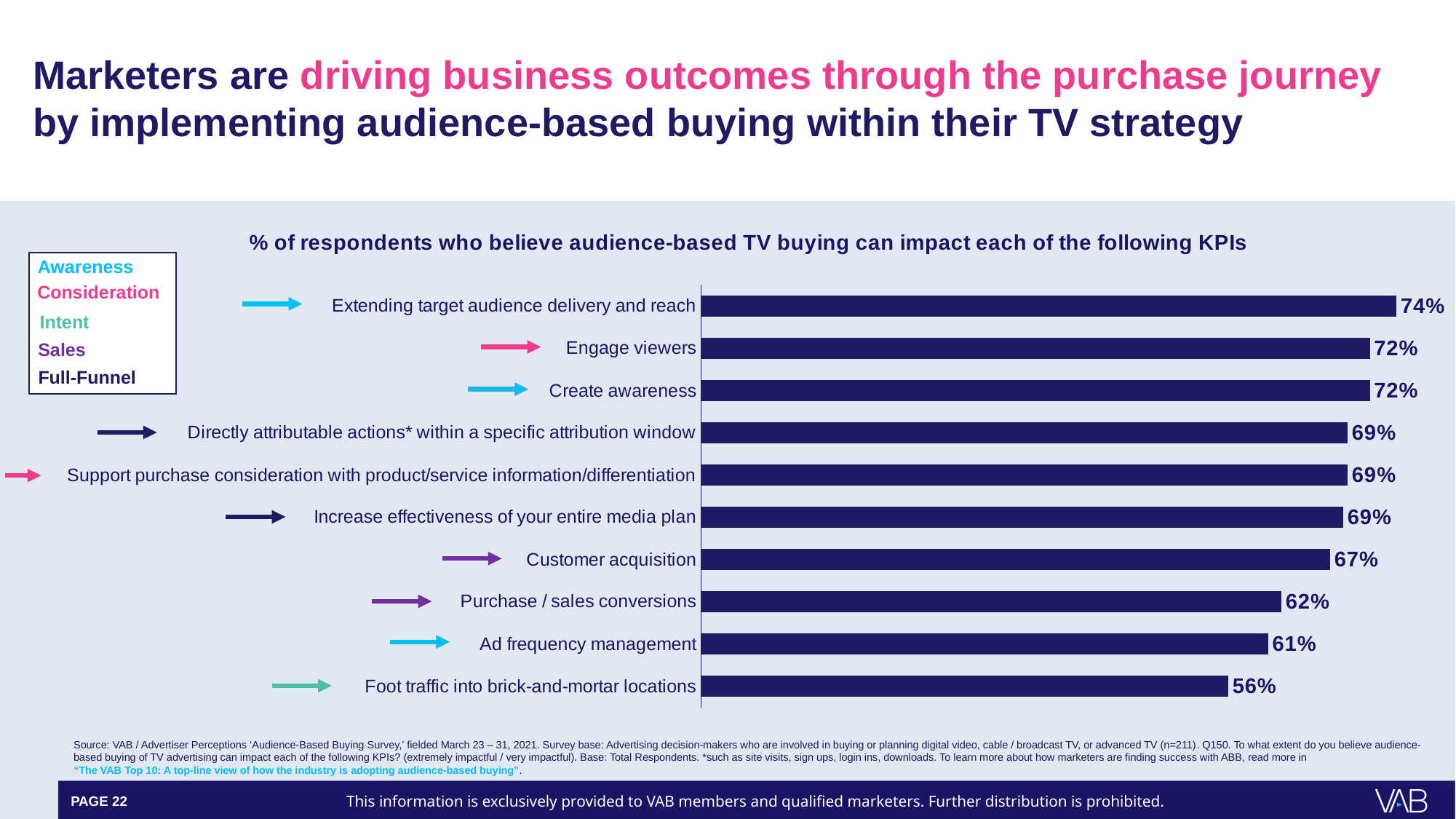
Which KPI has the highest percentage of respondents? Extending target audience delivery and reach What is the title of the chart? % of respondents who believe audience-based TV buying can impact each of the following KPIs What type of chart is shown on the slide? Bar chart What is the value shown for 'Customer acquisition'? 67% What percentage of respondents believe audience-based TV buying can impact 'Extending target audience delivery and reach'? 74% How many KPIs are plotted in the chart? 10 What is the value shown for 'Ad frequency management'? 61% What is the difference in percentage points between 'Extending target audience delivery and reach' and 'Foot traffic into brick-and-mortar locations'? 18 How many KPIs share the value 69%? 3 Which KPI has the lowest percentage of respondents? Foot traffic into brick-and-mortar locations What is the value shown for 'Foot traffic into brick-and-mortar locations'? 56% Which has a higher value: 'Purchase / sales conversions' or 'Customer acquisition'? Customer acquisition